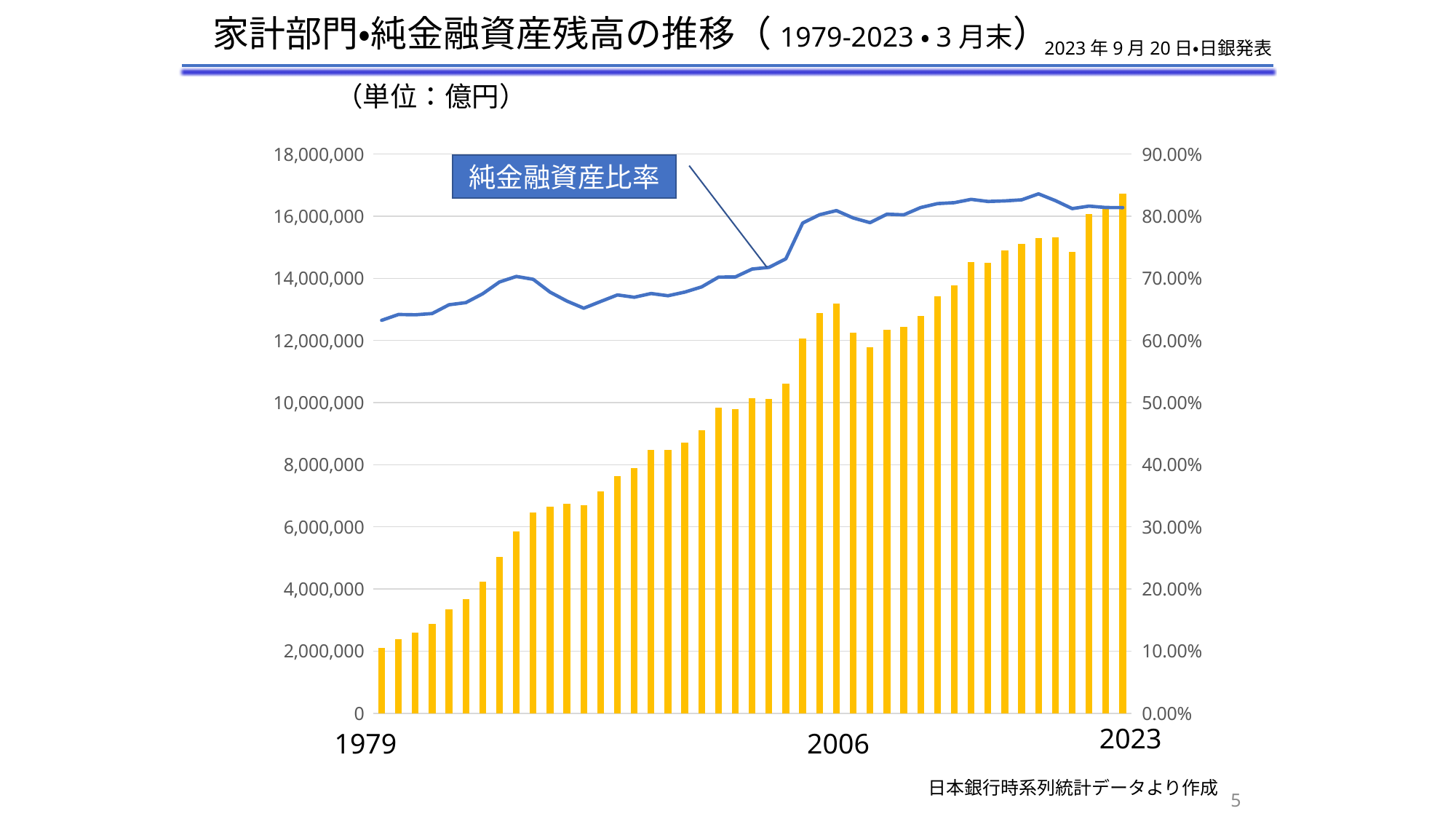
How many yearly bars are plotted in the chart (1979 to 2023)? 45 Is the 純金融資産比率 line higher in 1979 or in 2023? 2023 Is the bar value for 2006 greater or less than 12,000,000? greater Is the 純金融資産比率 line value for 1979 greater or less than 70.00%? less Which year has the lowest bar for net financial assets? 1979 What unit is stated for the chart's values? 億円 Is the bar value for 2023 greater or less than 16,000,000? greater What kind of chart is shown on the slide? A combination of a bar chart and a line chart Which is larger, the bar for 2006 or the bar for 2023? 2023 Do the bar values generally rise or fall from 1979 to 2023? rise Which year has the highest bar for net financial assets? 2023